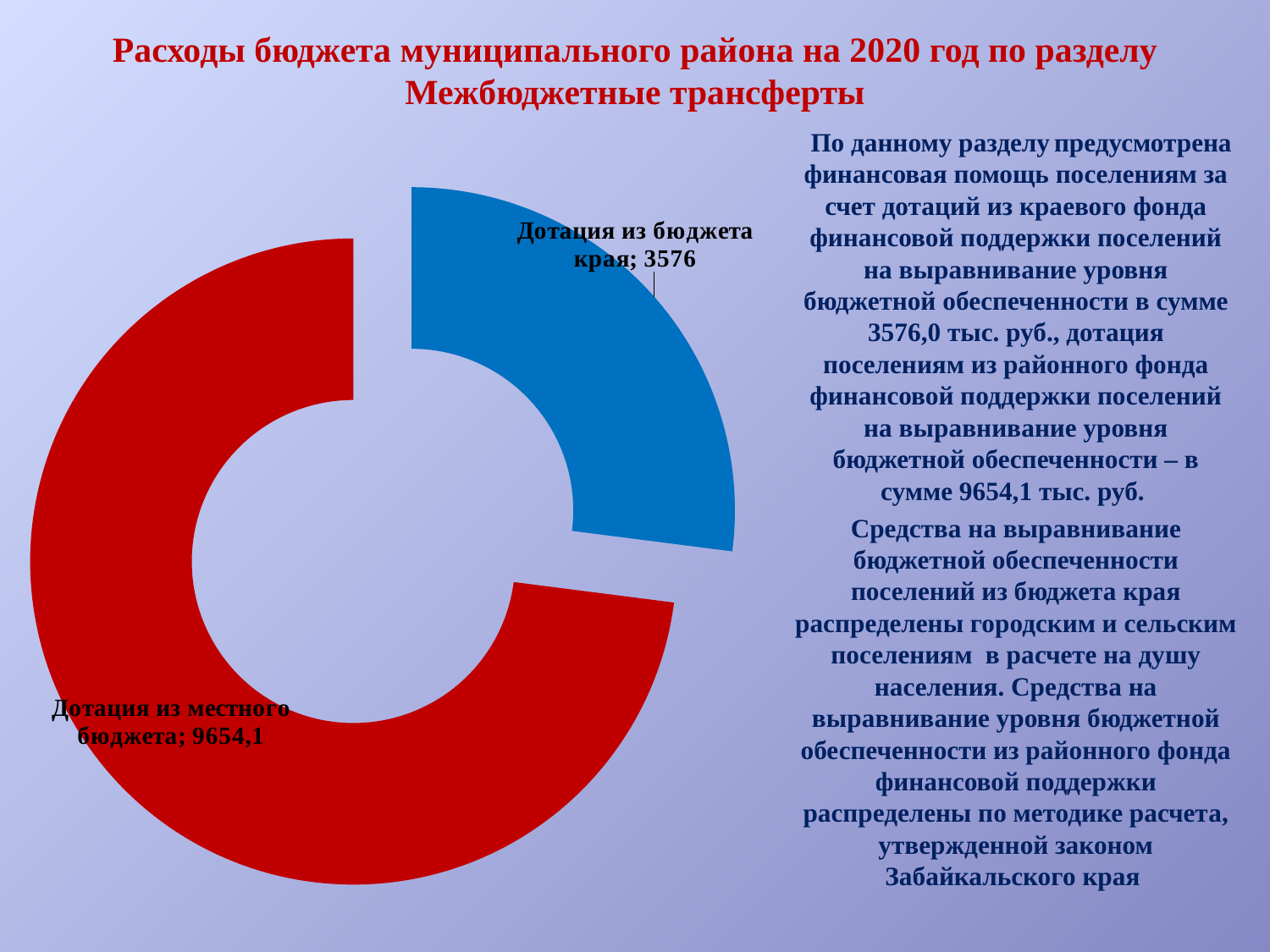
How many categories are shown in the chart? 2 What is the value for Дотация из бюджета края? 3576 Which category has the largest value? Дотация из местного бюджета What share of the total does Дотация из бюджета края represent, to the nearest whole percent? 27% What kind of chart is shown on the slide? Doughnut (pie) chart What is the value for Дотация из местного бюджета? 9654,1 What is the total of the two values shown in the chart? 13230,1 What is the difference between Дотация из местного бюджета and Дотация из бюджета края? 6078,1 What colour is the slice for Дотация из местного бюджета? Red What is the title of the chart slide? Расходы бюджета муниципального района на 2020 год по разделу Межбюджетные трансферты Which category has the smallest value? Дотация из бюджета края Which is larger: Дотация из бюджета края or Дотация из местного бюджета? Дотация из местного бюджета